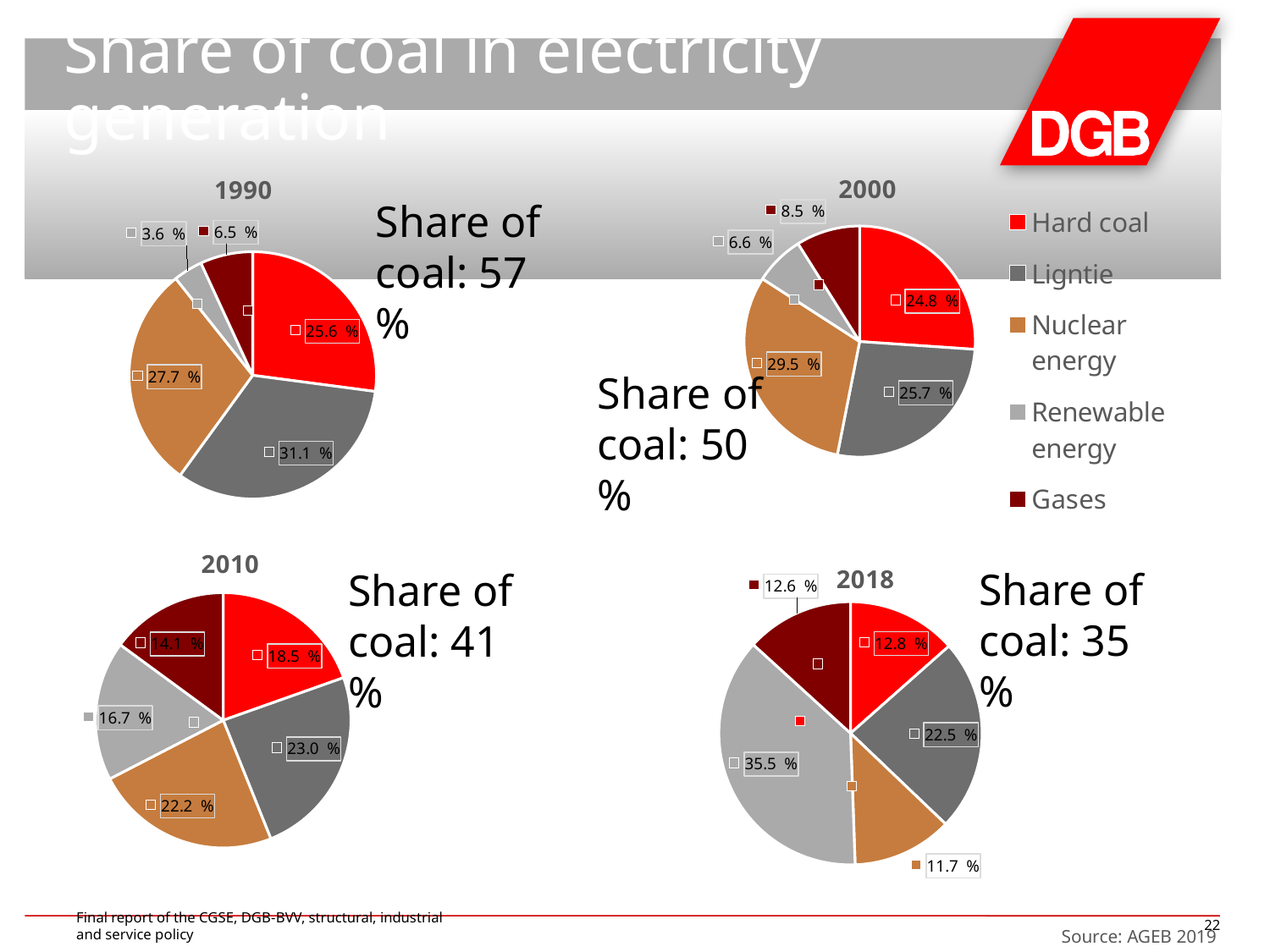
In the 2018 pie chart, what is the value for Renewable energy? 35.5 % In the 1990 pie chart, which category has the smallest slice? Renewable energy What kind of chart is used for the 1990 data? Pie chart In the 2018 pie chart, which category has the largest slice? Renewable energy In the 2000 pie chart, what is the value for Gases? 8.5 % In the 2018 pie chart, which is larger, Ligntie or Nuclear energy? Ligntie Across the four charts from 1990 to 2018, does the stated share of coal rise or fall? Fall How many slices does the 2010 pie chart have? 5 In the 2010 pie chart, what is the difference between the Ligntie value and the Hard coal value? 4.5 % In the 2000 pie chart, which category has the largest slice? Nuclear energy How many entries does the legend list? 5 In the 1990 pie chart, what is the value for Hard coal? 25.6 %